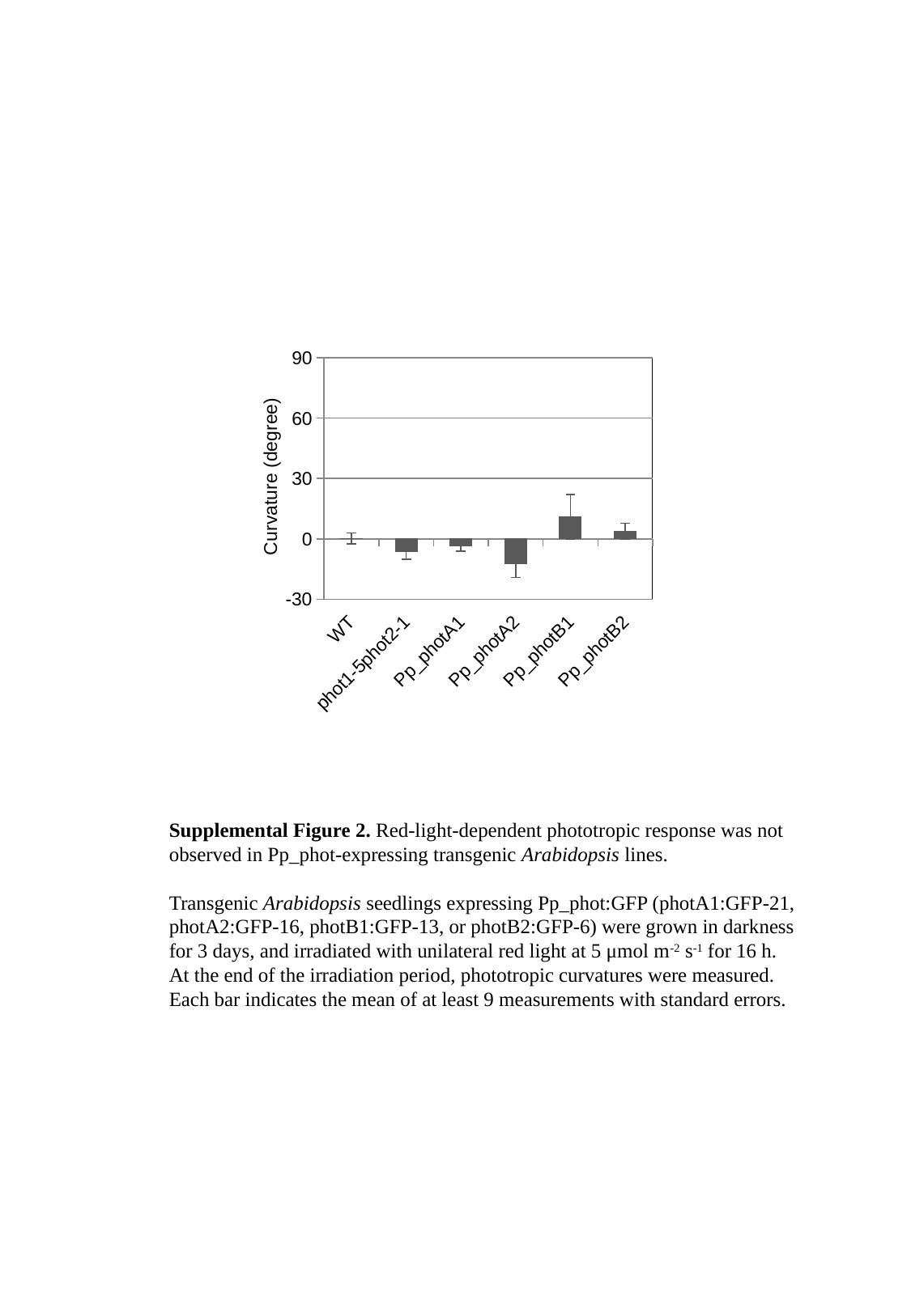
How many categories are plotted on the x axis of the chart? 6 What is the title of the y axis of the chart? Curvature (degree) Which category has the lowest curvature value in the chart? Pp_photA2 What is the highest tick value shown on the y axis of the chart? 90 Is the value for Pp_photA2 greater or less than 0? less Which has the larger curvature value, Pp_photB2 or phot1-5phot2-1? Pp_photB2 Is the value for Pp_photB1 greater or less than 30? less Is the value for Pp_photB1 greater or less than 0? greater Which has the larger curvature value, Pp_photB1 or Pp_photA2? Pp_photB1 What kind of chart is shown on the slide? bar chart Which category has the highest curvature value in the chart? Pp_photB1